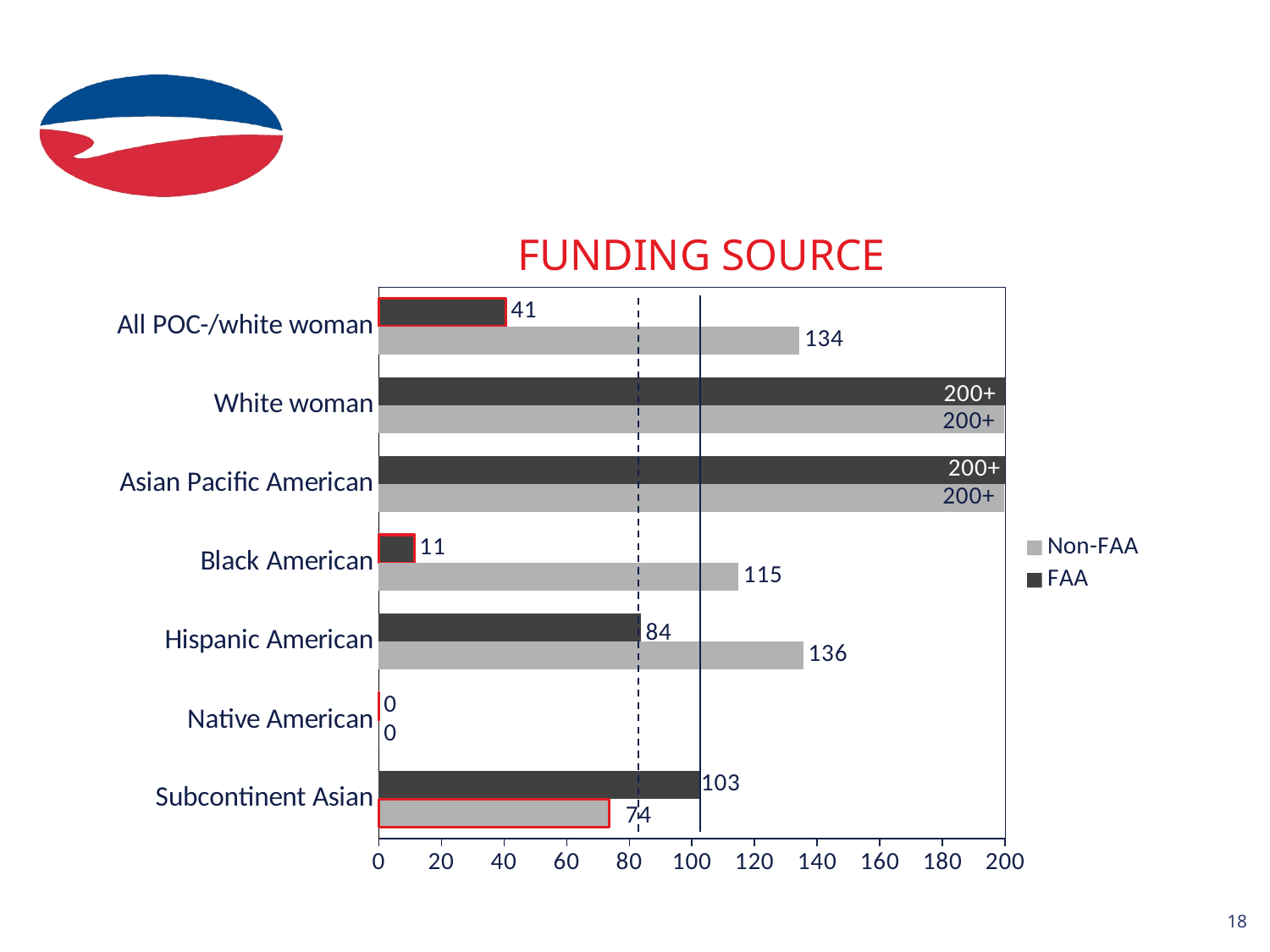
What type of chart is shown on the slide? Bar chart What is the Non-FAA value for Hispanic American? 136 Which category has the lowest Non-FAA value? Native American What is the FAA value for Subcontinent Asian? 103 For Subcontinent Asian, which is larger, the FAA value or the Non-FAA value? FAA What is the difference between the Non-FAA and FAA values for Hispanic American? 52 What is the FAA value for Native American? 0 What is the Non-FAA value for All POC-/white woman? 134 What is the difference between the Non-FAA and FAA values for Black American? 104 What is the FAA value for Black American? 11 How many categories are shown on the chart? 7 How many series does the legend list? 2